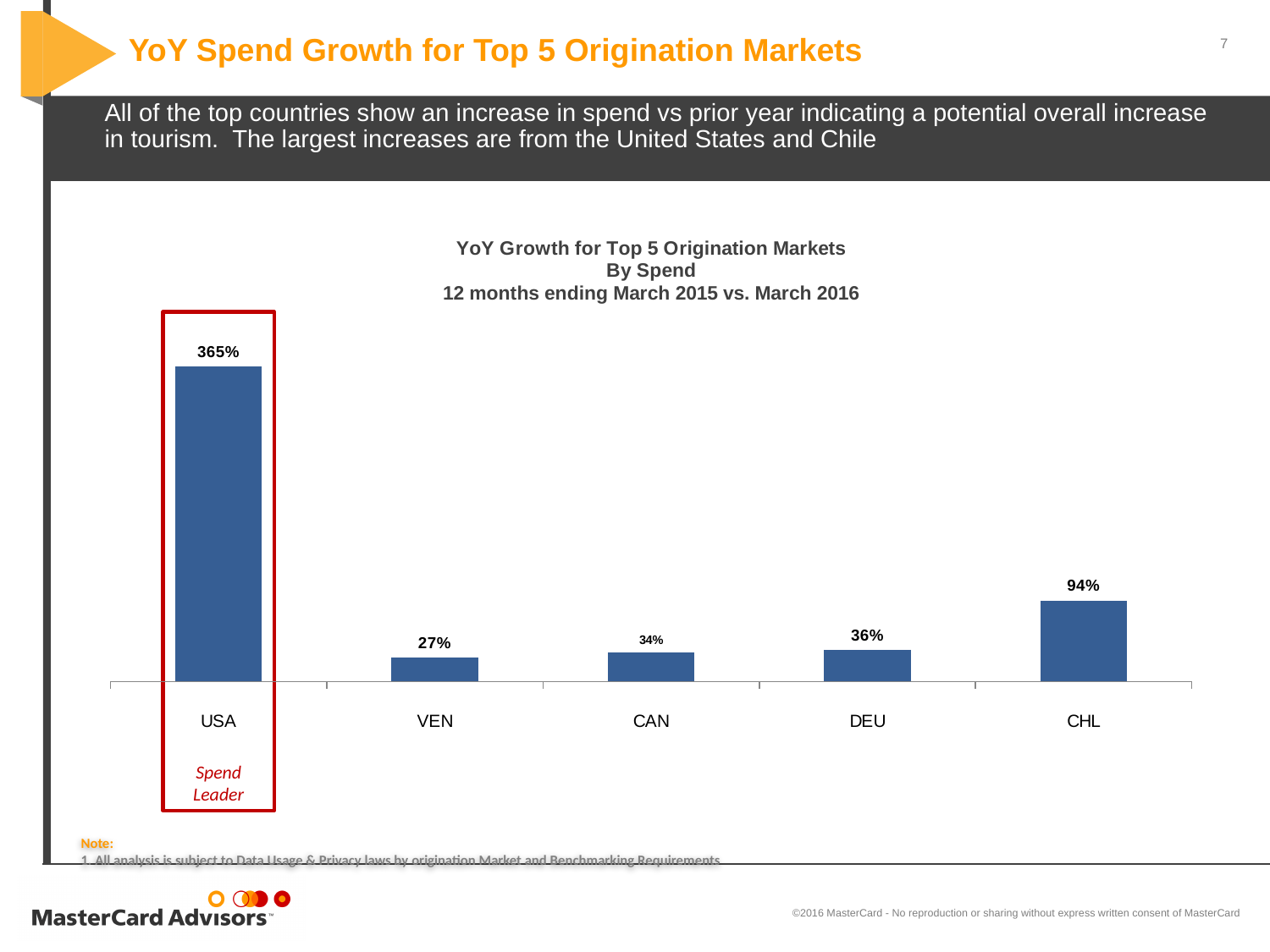
What is the YoY spend growth value for USA? 365% Which origination market has the highest YoY spend growth? USA Which origination market has the lowest YoY spend growth? VEN How many origination markets are shown in the chart? 5 Which market is labelled as the 'Spend Leader' in the chart? USA What is the difference between the YoY spend growth for USA and CHL? 271% What is the difference between the YoY spend growth for DEU and CAN? 2% What kind of chart is shown on the slide? Bar chart Which has a larger YoY spend growth, CHL or DEU? CHL What is the YoY spend growth value for DEU? 36% What is the YoY spend growth value for CHL? 94% What is the YoY spend growth value for VEN? 27%